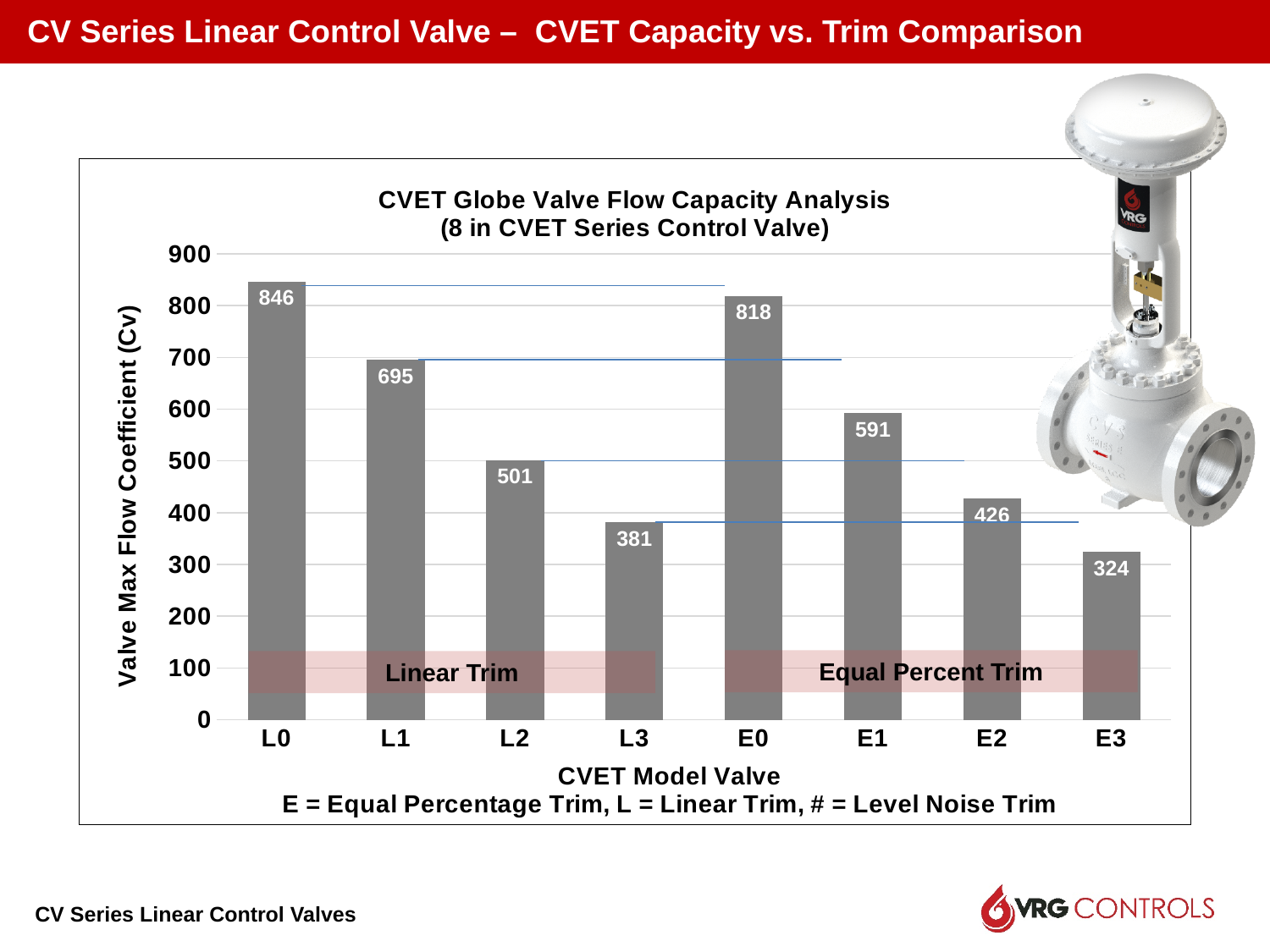
How many CVET models are plotted on the x axis? 8 What is the valve max flow coefficient for model E1? 591 What is the title of the chart? CVET Globe Valve Flow Capacity Analysis (8 in CVET Series Control Valve) What is the difference between the values for L1 and E1? 104 Which CVET model has the highest valve max flow coefficient? L0 What kind of chart is shown on the slide? Bar chart Which CVET model has the lowest valve max flow coefficient? E3 Which has a larger valve max flow coefficient, L2 or E2? L2 Do the values rise or fall from L0 to L3? Fall What is the difference between the values for L0 and E0? 28 What is the valve max flow coefficient for model L0? 846 What is the value shown for model L3? 381